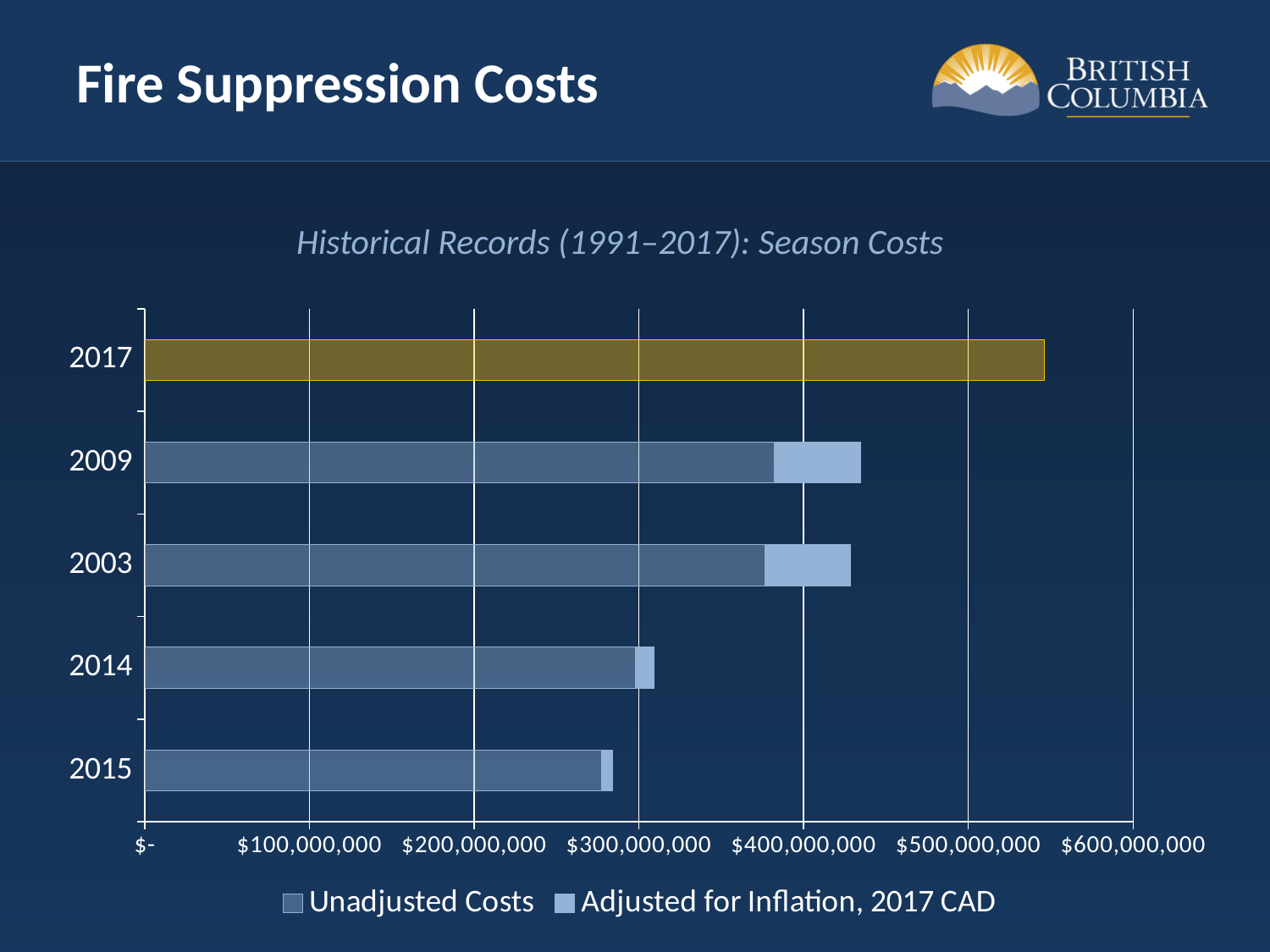
How many series does the legend list? 2 What kind of chart is shown on the slide? Bar chart Which year has the lowest total season cost? 2015 What is the title of the chart? Historical Records (1991–2017): Season Costs Which year has the highest total season cost? 2017 Is the total value for 2003 greater or less than $500,000,000? less Is the total value for 2009 greater or less than $400,000,000? greater What are the two series named in the legend? Unadjusted Costs; Adjusted for Inflation, 2017 CAD How many years are shown on the chart? 5 Is the total value for 2015 greater or less than $300,000,000? less Which year has a larger total season cost, 2009 or 2015? 2009